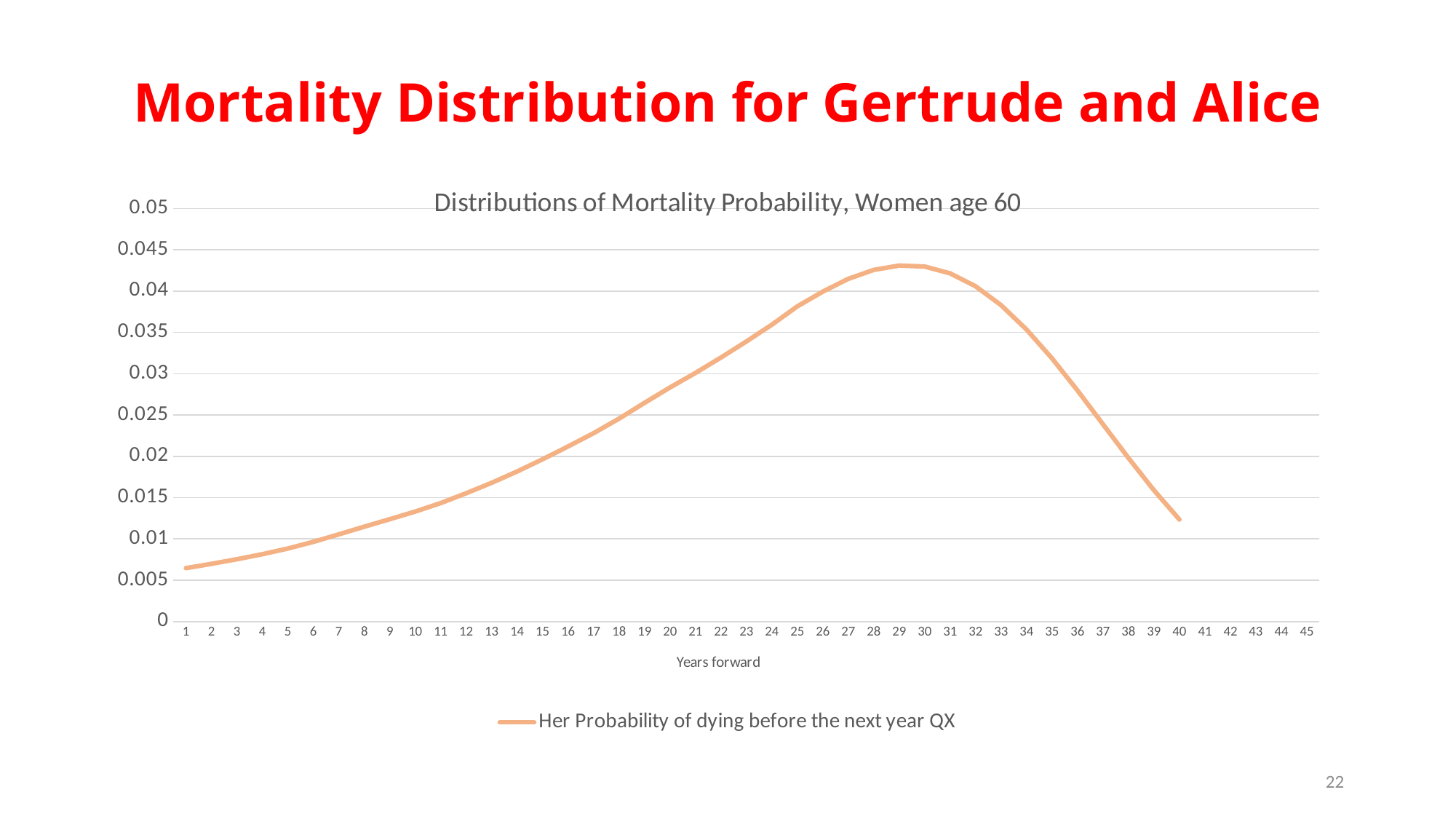
What is the title of the chart? Distributions of Mortality Probability, Women age 60 At which year forward is the plotted value lowest? 1 Is the value at year 1 greater or less than 0.01? less Is the value at year 29 greater or less than 0.04? greater Is the value at year 40 greater or less than 0.015? less Which is larger, the value at year 10 or the value at year 30? year 30 What kind of chart is shown on the slide? line chart How many series does the legend list? 1 Do the values rise or fall between year 30 and year 40? fall What is the last year forward for which a value is plotted? 40 What is the legend entry for the plotted line? Her Probability of dying before the next year QX